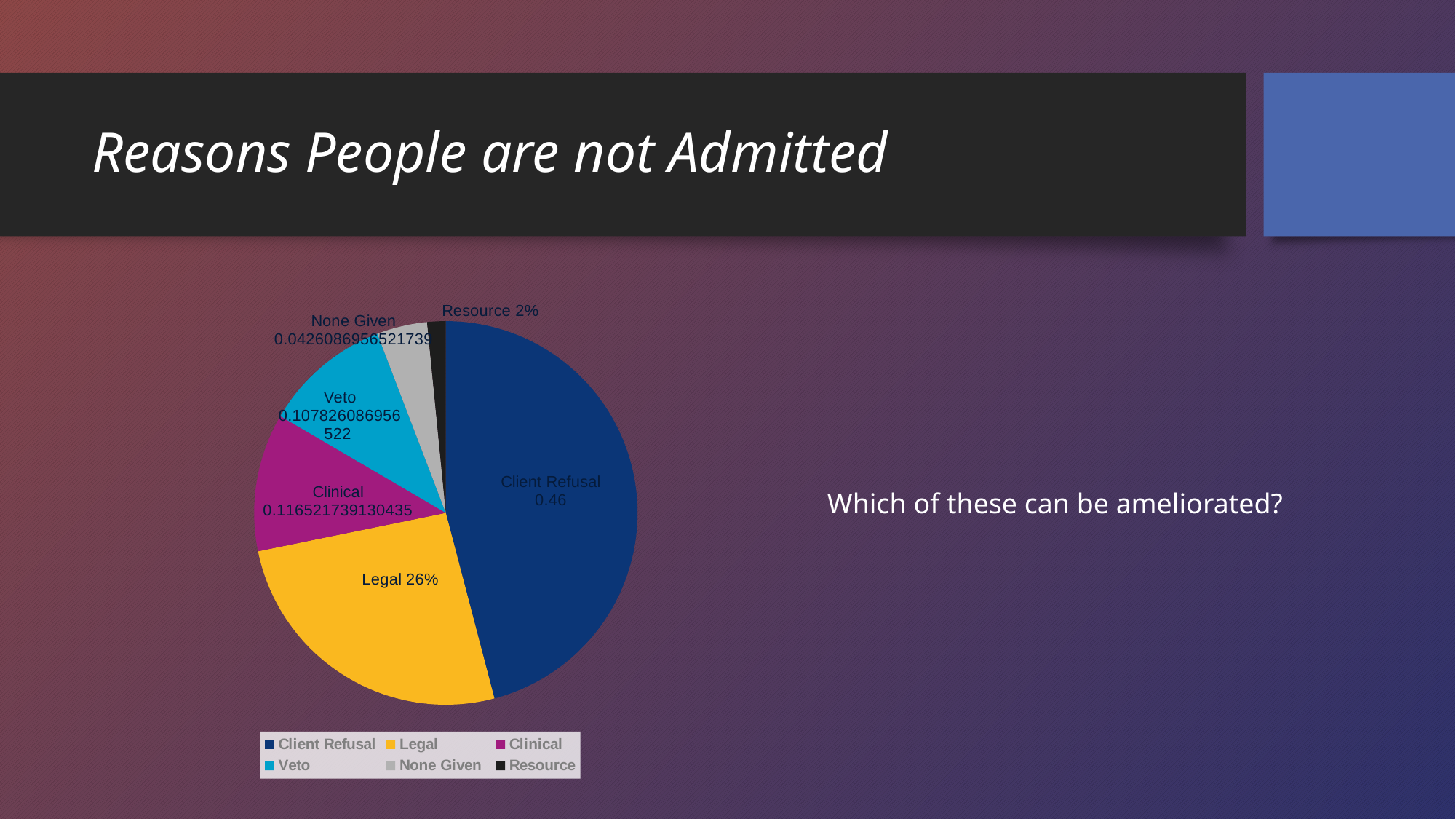
What value is labelled on the Clinical slice? 0.116521739130435 What percentage is shown for the Legal slice? 26% Which reason has the smallest slice of the pie? Resource What colour is the Legal slice in the pie chart? Yellow Which slice is larger, Clinical or Veto? Clinical What type of chart is shown on the slide? Pie chart Which reason has the largest slice of the pie? Client Refusal What percentage is shown for the Resource slice? 2% What value is shown for the Client Refusal slice of the pie chart? 0.46 What value is labelled on the Veto slice? 0.107826086956522 What value is labelled on the None Given slice? 0.0426086956521739 How many slices does the pie chart have? 6